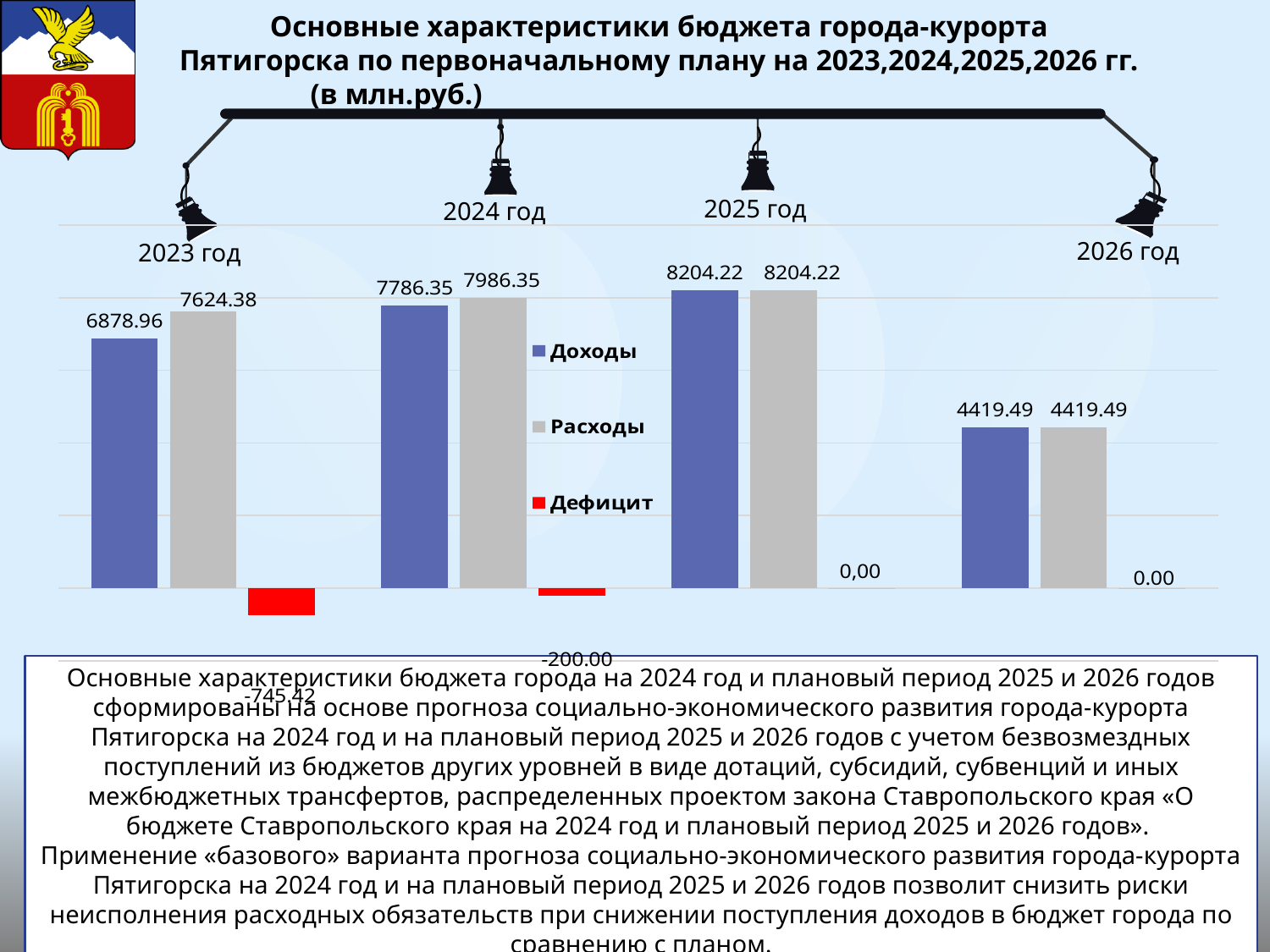
In 2023 год, which is larger: Доходы or Расходы? Расходы What is the difference between Расходы and Доходы in 2024 год? 200.00 What kind of chart is shown on the slide? bar chart How many series does the legend list? 3 What is the value of Доходы for 2023 год? 6878.96 What is the value of Расходы for 2024 год? 7986.35 What is the value of Дефицит for 2025 год? 0,00 Which year has the lowest value of Расходы? 2026 год By how much do Расходы exceed Доходы in 2023 год? 745.42 What is the value of Доходы for 2025 год? 8204.22 What is the value of Расходы for 2026 год? 4419.49 Which year has the highest value of Доходы? 2025 год